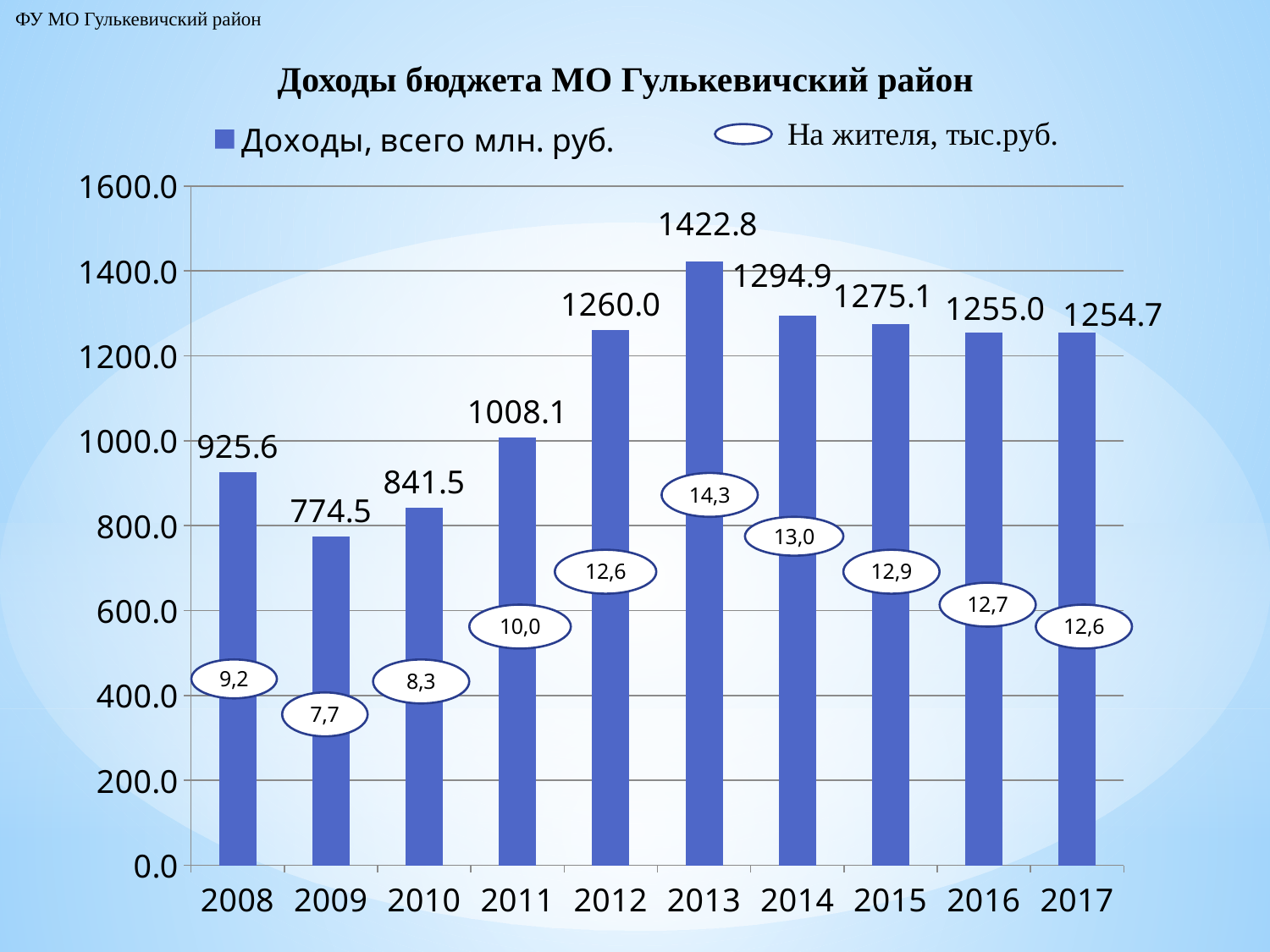
Which year has the lowest total budget income? 2009 Which year has the highest total budget income? 2013 What is the total budget income (Доходы, всего млн. руб.) for 2013? 1422.8 What is the total budget income (Доходы, всего млн. руб.) for 2009? 774.5 What is the per-resident value (На жителя, тыс.руб.) shown for 2008? 9,2 Which year has the larger total budget income, 2011 or 2010? 2011 What is the per-resident value (На жителя, тыс.руб.) shown for 2014? 13,0 What is the title of the chart? Доходы бюджета МО Гулькевичский район What is the difference in total budget income between 2013 and 2012? 162.8 What kind of chart is shown on the slide? Bar chart How many series does the legend list? 2 How many years are shown on the x axis? 10